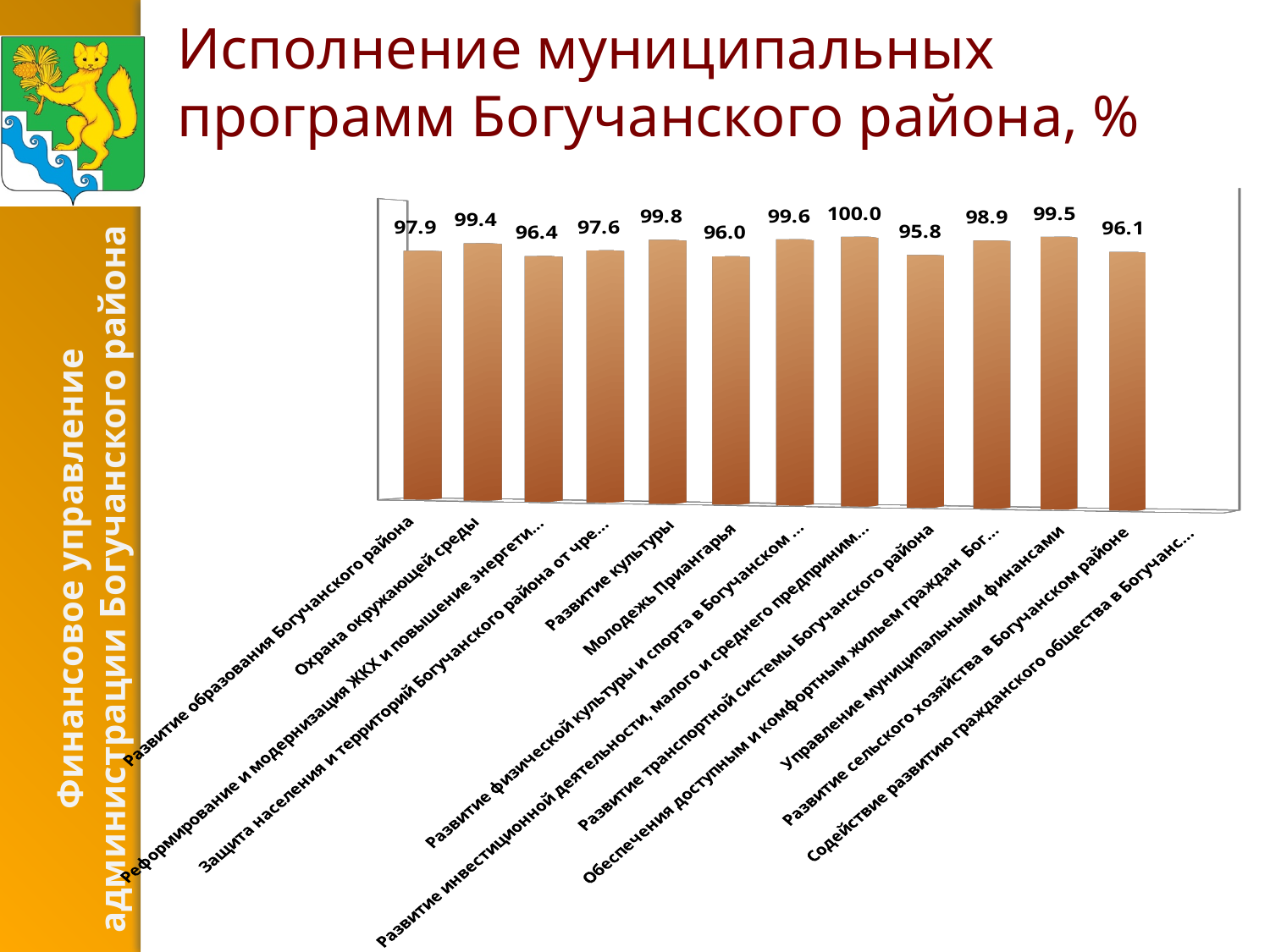
What is the title of the chart on the slide? Исполнение муниципальных программ Богучанского района, % What is the lowest value shown in the chart? 95.8 What type of chart is shown on the slide? bar chart How many bars in the chart have a value of exactly 100.0? 1 What is the value of the last bar on the right in the chart? 96.1 What is the difference between the first bar (97.9) and the second bar (99.4) in the chart? 1.5 What is the value of the first bar from the left (Развитие образования Богучанского района)? 97.9 What is the difference between the highest value (100.0) and the lowest value (95.8) in the chart? 4.2 Which is larger: the value of the second bar from the left (99.4) or the third bar from the left (96.4)? 99.4 What is the highest value shown in the chart? 100.0 What is the value of the fifth bar from the left in the chart? 99.8 What is the value of the second bar from the left in the chart? 99.4